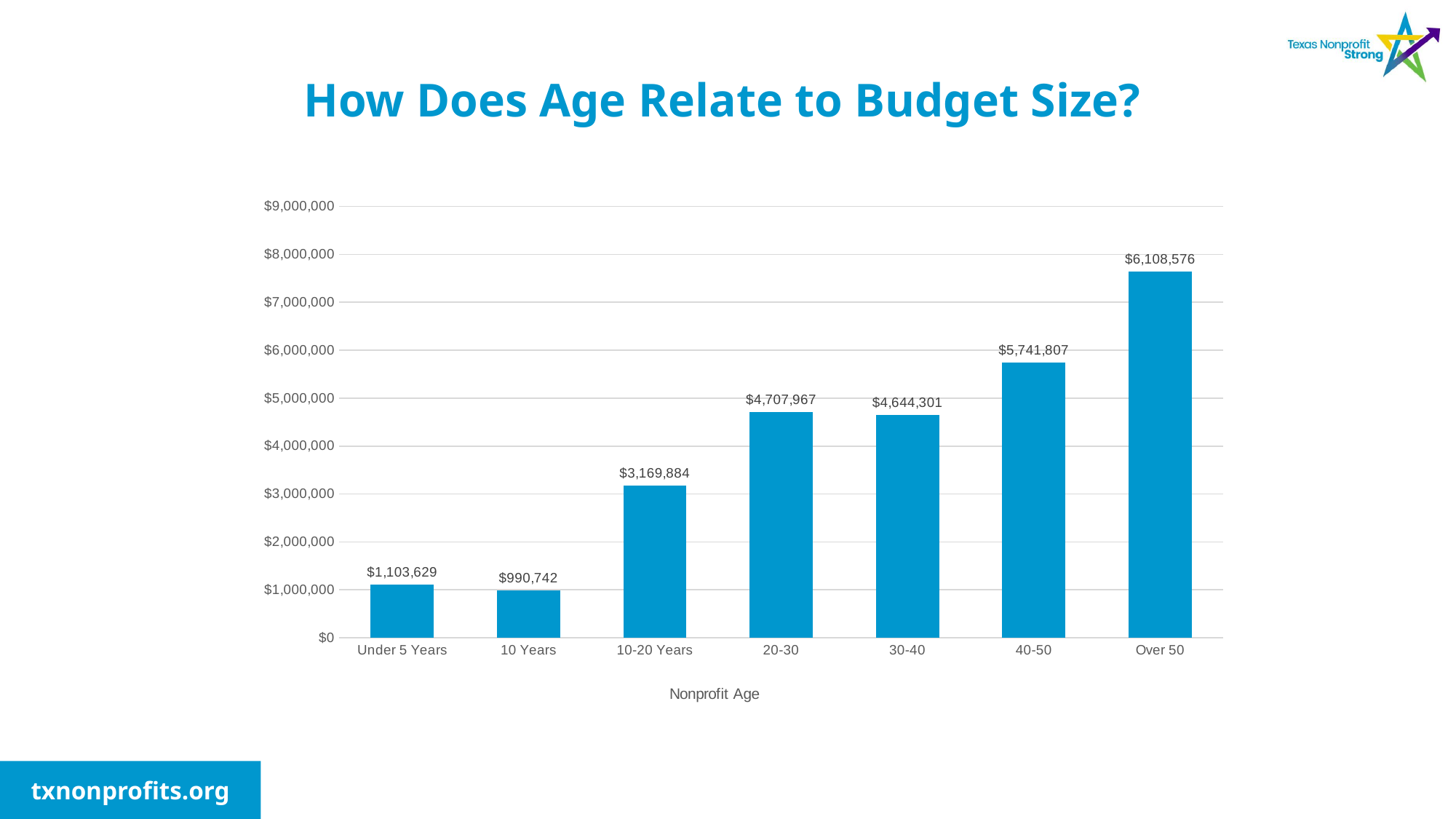
What kind of chart is shown on the slide? bar chart What is the value for the Under 5 Years category? $1,103,629 What is the value for the 10-20 Years category? $3,169,884 Is the value for 10-20 Years greater or less than $3,000,000? greater Which is larger, the value for 20-30 or the value for 30-40? 20-30 Which category has the lowest value? 10 Years What is the difference between the values for Under 5 Years and 10 Years? $112,887 What is the label of the x axis? Nonprofit Age What is the value for the 40-50 category? $5,741,807 How many categories are shown on the x axis? 7 What is the difference between the values for 20-30 and 30-40? $63,666 Which category has the highest value? Over 50